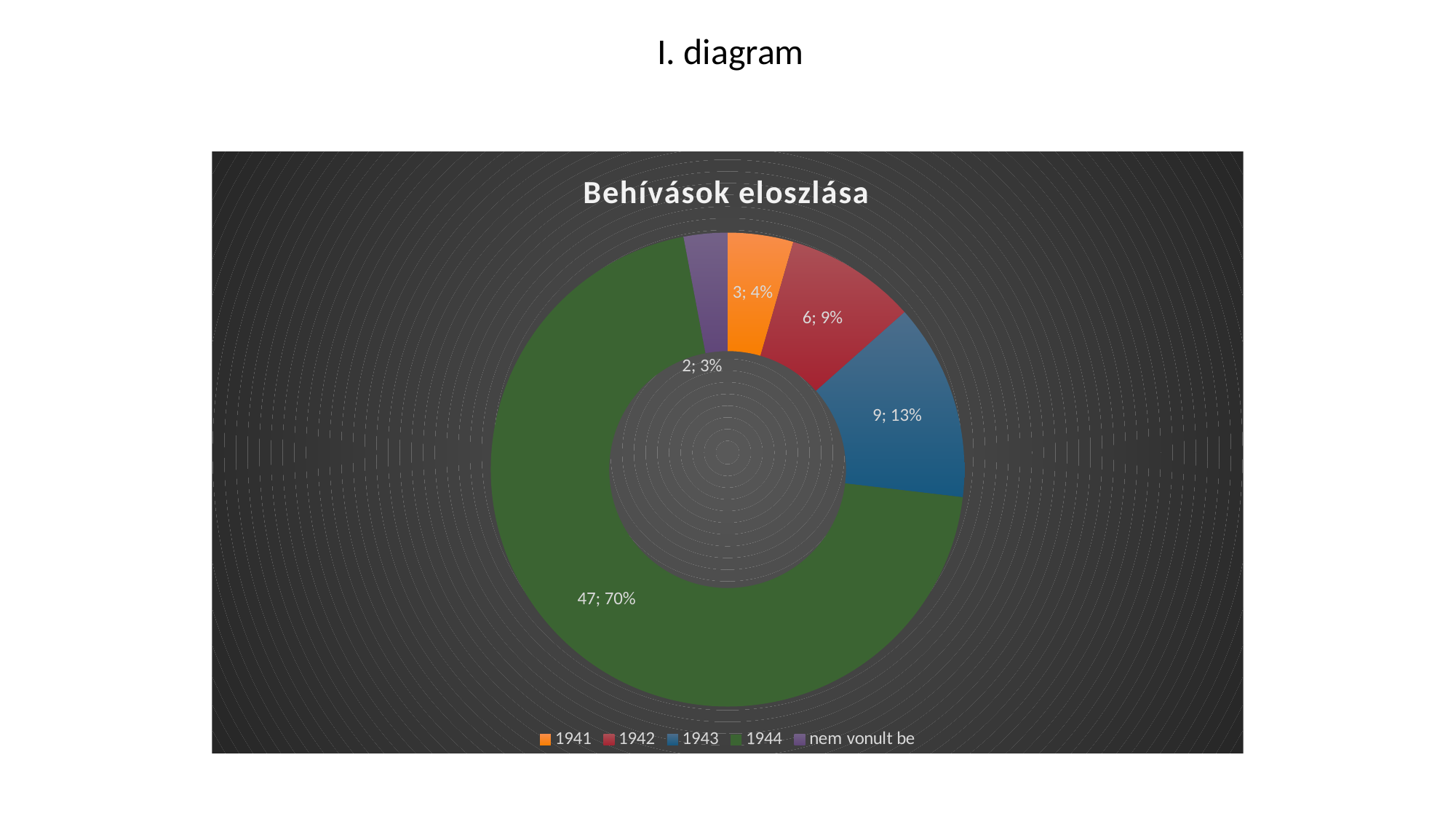
Which category has the smallest share? nem vonult be What percentage share does the 'nem vonult be' category have? 3% What is the title of the chart? Behívások eloszlása What is the count shown for 1944? 47 What is the count shown for 1942? 6 Which is larger, the count for 1942 or the count for 1943? 1943 What percentage share does 1943 have? 13% What is the difference between the counts for 1943 and 1941? 6 Which category has the largest share? 1944 How many categories does the legend list? 5 What kind of chart is shown on the slide? Doughnut chart What colour is the 1944 segment? Green